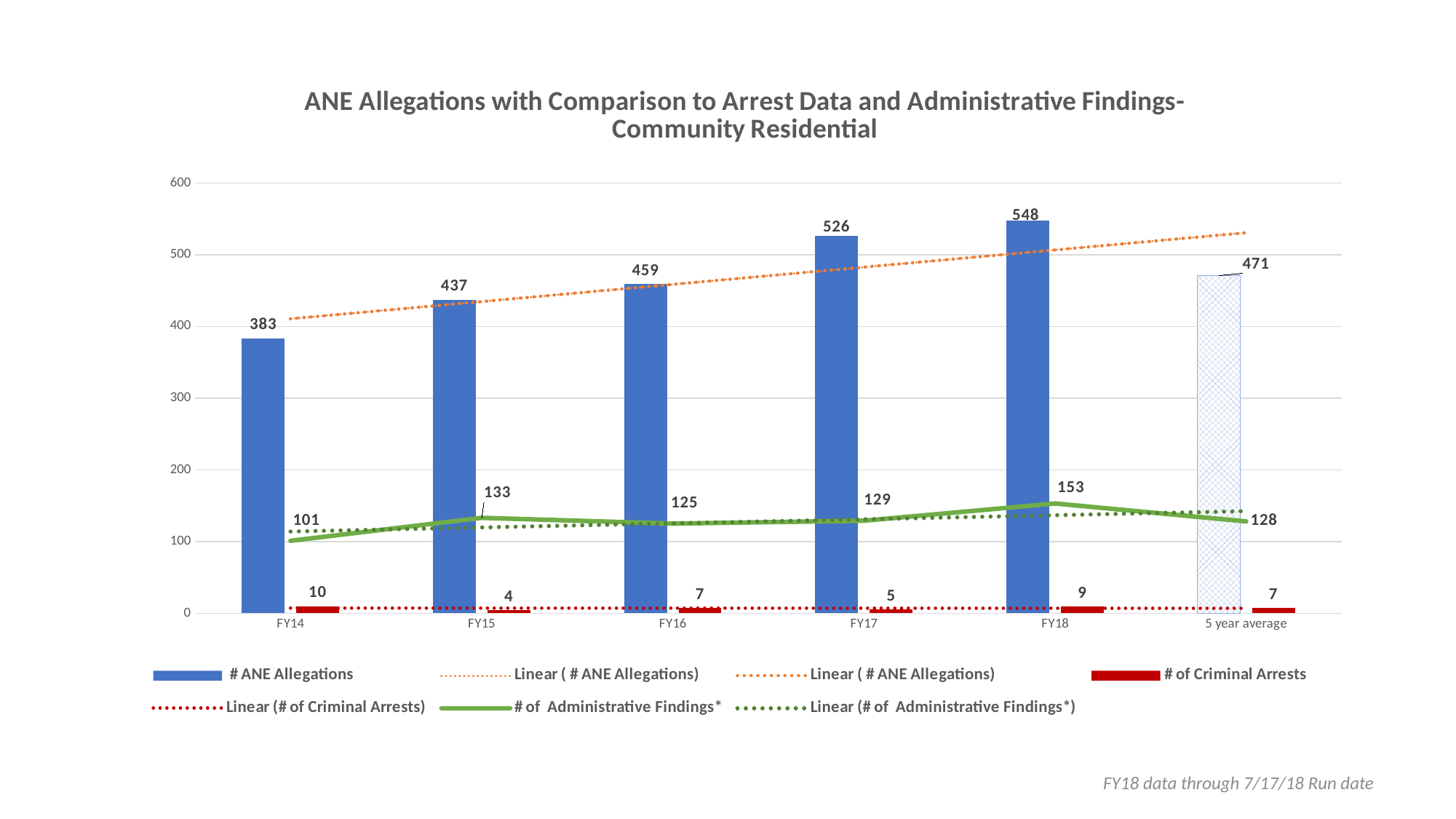
Which fiscal year has the lowest number of Criminal Arrests? FY15 What is the number of Administrative Findings for FY18? 153 Do the ANE Allegations rise or fall from FY14 to FY18? rise Is the number of ANE Allegations for FY17 greater or less than 500? greater What is the number of ANE Allegations for FY16? 459 What is the number of Criminal Arrests for FY14? 10 What is the difference in ANE Allegations between FY18 and FY14? 165 Which is larger, the number of Administrative Findings in FY15 or in FY16? FY15 Which fiscal year has the highest number of ANE Allegations? FY18 What is the 5 year average of ANE Allegations? 471 What colour are the # of Criminal Arrests bars? Red How many categories are shown on the x axis? 6